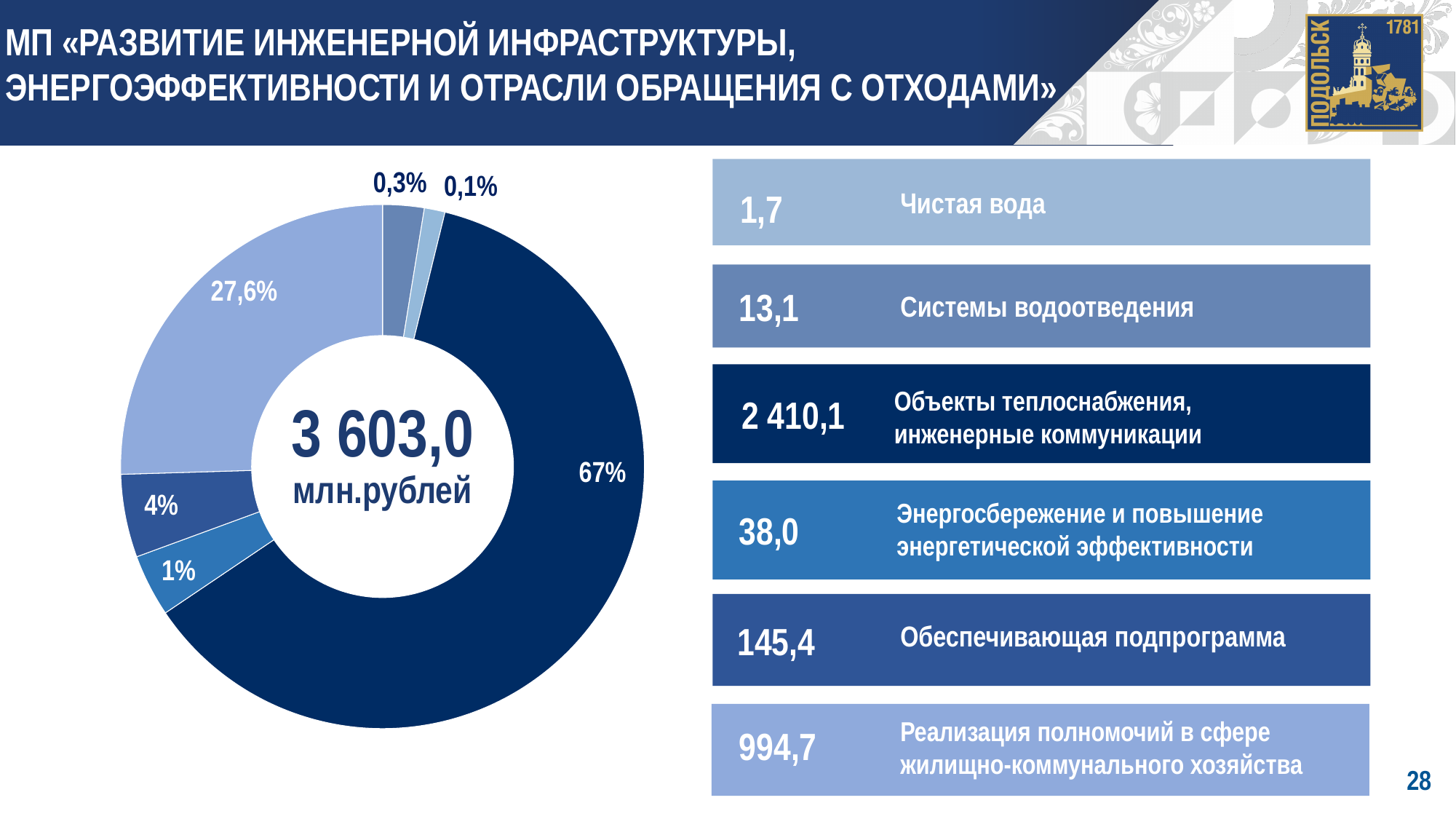
What value is listed for «Объекты теплоснабжения, инженерные коммуникации»? 2 410,1 How many categories are listed in the legend to the right of the donut chart? 6 What is the difference between the values for «Реализация полномочий в сфере жилищно-коммунального хозяйства» and «Обеспечивающая подпрограмма»? 849,3 What is the largest percentage shown on the donut chart? 67% Which is larger: the value for «Системы водоотведения» or for «Энергосбережение и повышение энергетической эффективности»? Энергосбережение и повышение энергетической эффективности What value is listed for «Обеспечивающая подпрограмма»? 145,4 What total value is shown in the centre of the donut chart? 3 603,0 млн.рублей What value is listed for «Чистая вода»? 1,7 What type of chart is shown on the slide? Pie chart (donut) How many slices does the donut chart have? 6 What is the smallest percentage shown on the donut chart? 0,1% What percentage is shown for the second-largest slice of the donut chart? 27,6%